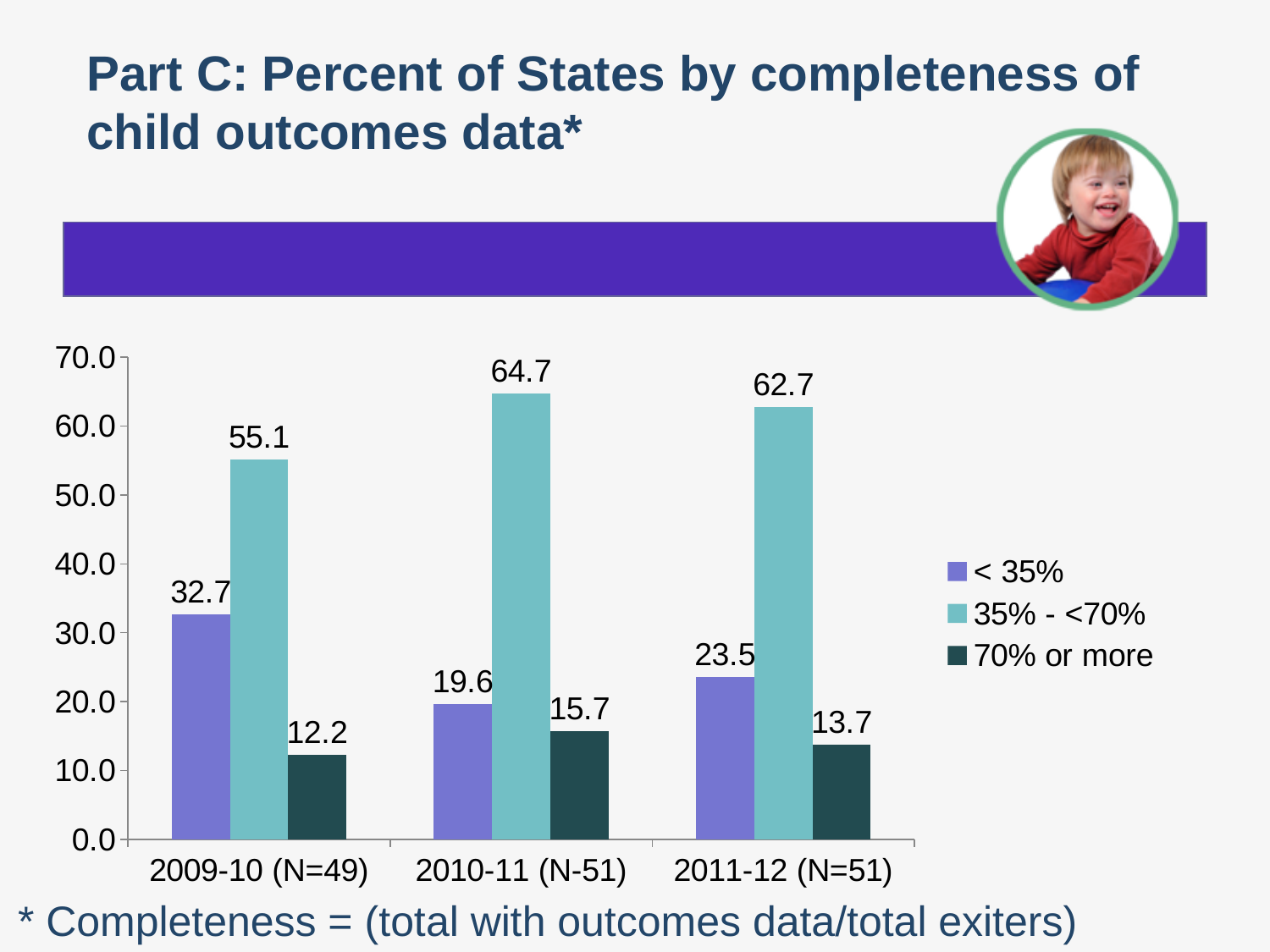
What is the difference between the "35% - <70%" value and the "< 35%" value in 2009-10 (N=49)? 22.4 What kind of chart is shown on the slide? bar chart In which year group is the "70% or more" series lowest? 2009-10 (N=49) Which is larger in 2011-12 (N=51): the "< 35%" value or the "70% or more" value? < 35% Does the "< 35%" series rise or fall from 2009-10 (N=49) to 2010-11 (N-51)? fall How many series does the legend list? 3 What is the value for the "70% or more" series in 2011-12 (N=51)? 13.7 What is the value for the "35% - <70%" series in 2010-11 (N-51)? 64.7 Which legend entry is shown in dark teal? 70% or more In which year group is the "35% - <70%" series highest? 2010-11 (N-51) How many year groups are shown on the x axis? 3 What is the value for the "< 35%" series in 2009-10 (N=49)? 32.7